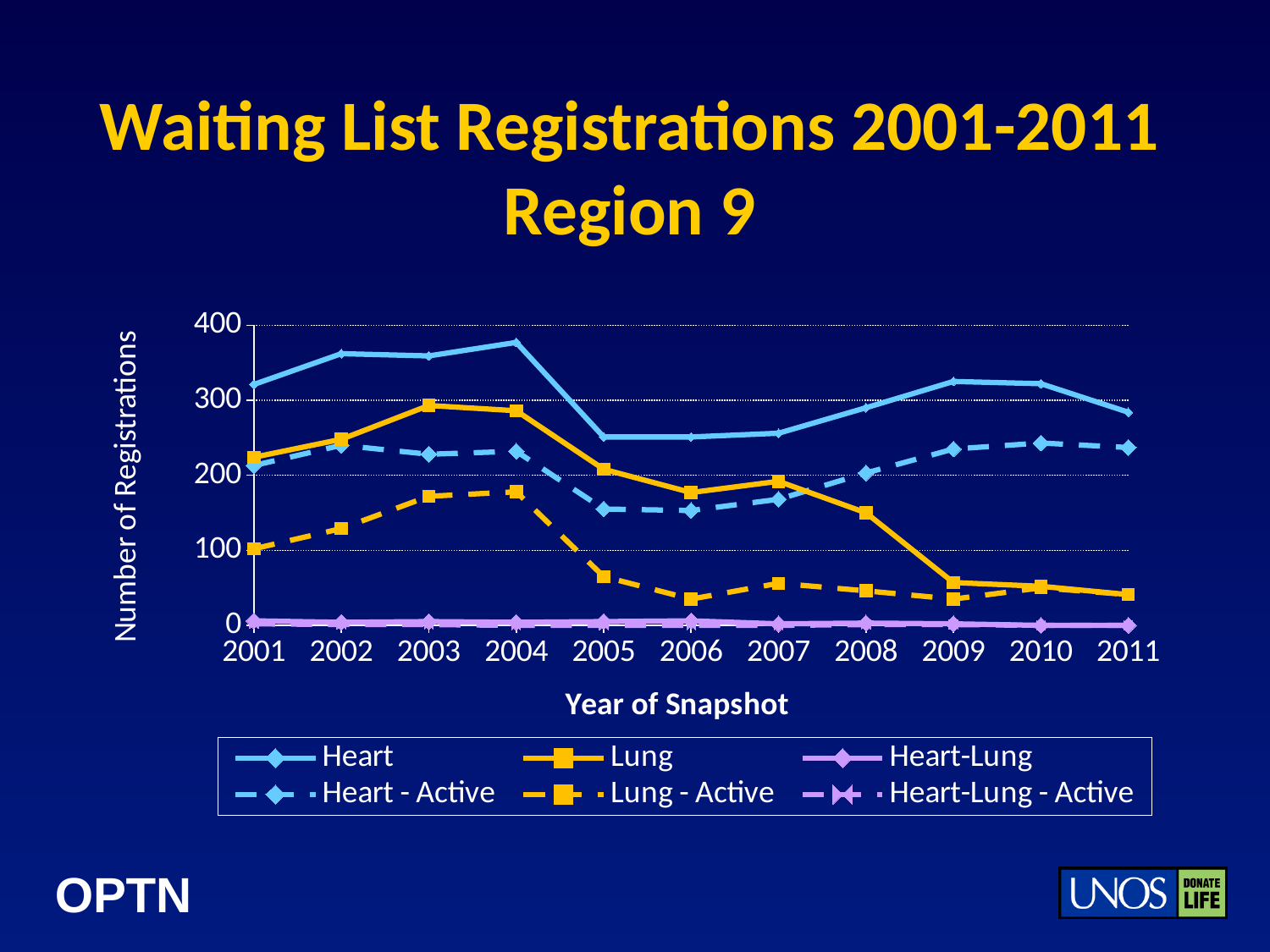
How many years are plotted along the x axis? 11 What is the label of the x axis? Year of Snapshot How many series does the legend list? 6 In which year does the Heart series reach its highest value? 2004 What kind of chart is shown on the slide? line chart Does the Lung series rise or fall between 2004 and 2011? fall In which year is the Lung series at its lowest value? 2011 In 2009, which series has the larger value, Heart or Lung? Heart Is the value for Lung in 2011 greater or less than 100? less Is the value for Heart - Active in 2006 greater or less than 200? less What is the title of the chart on the slide? Waiting List Registrations 2001-2011 Region 9 Is the value for Heart in 2004 greater or less than 300? greater